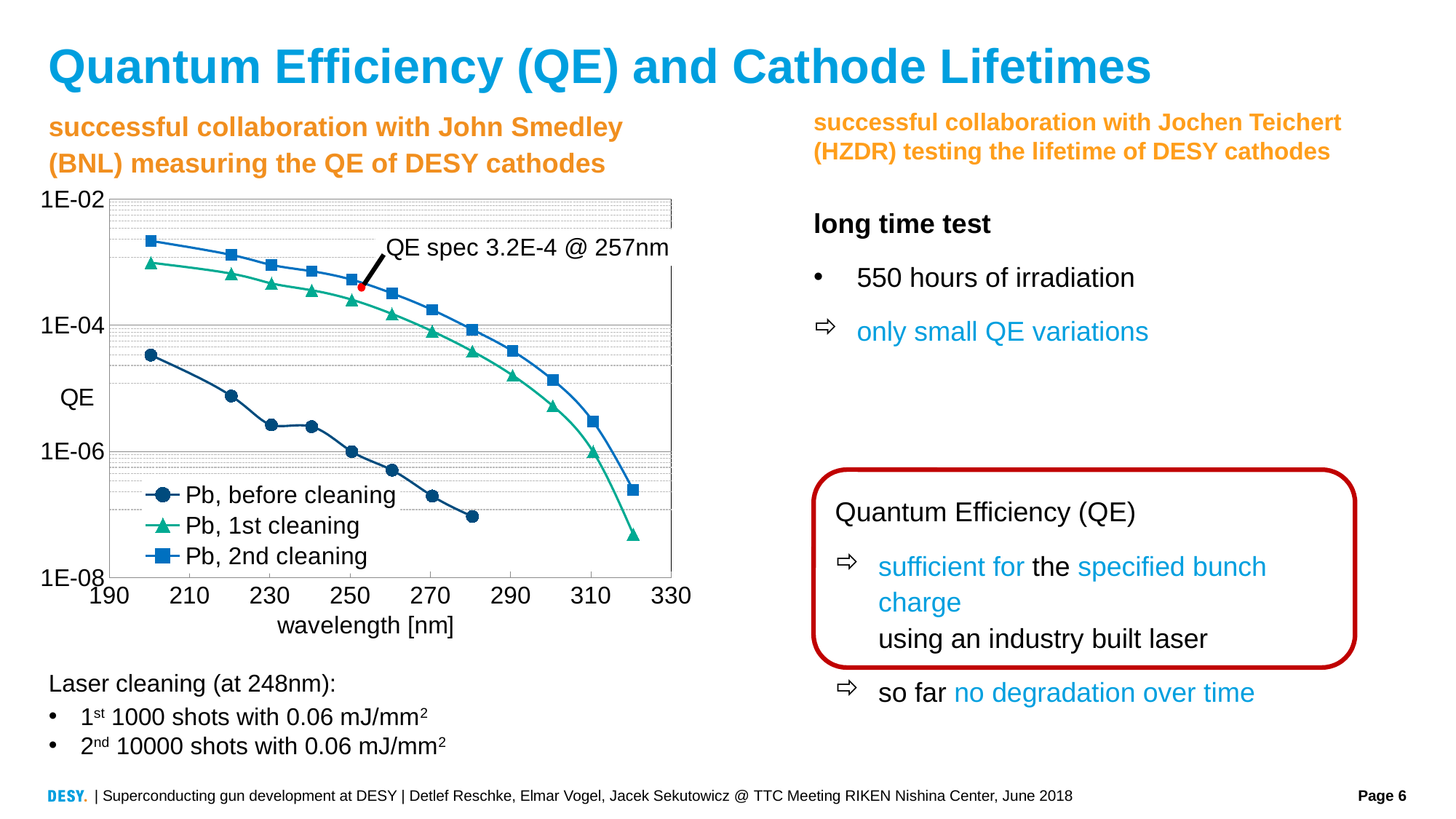
What is the label of the x axis of the chart? wavelength [nm] Which series has the lowest QE at 200 nm? Pb, before cleaning Is the QE for Pb, before cleaning at 280 nm greater or less than 1E-06? less What kind of chart is shown on the slide? line chart What QE spec value is annotated on the chart, and at which wavelength? 3.2E-4 @ 257nm At 250 nm, which series has the higher QE: Pb, 2nd cleaning or Pb, before cleaning? Pb, 2nd cleaning How many data points are plotted for the Pb, before cleaning series? 8 How does the QE change as the wavelength increases along the x axis? it falls Is the QE for Pb, before cleaning at 200 nm greater or less than 1E-04? less How many series does the chart legend list? 3 Which series has the highest QE at 200 nm? Pb, 2nd cleaning Is the QE for Pb, 2nd cleaning at 250 nm greater or less than 1E-04? greater